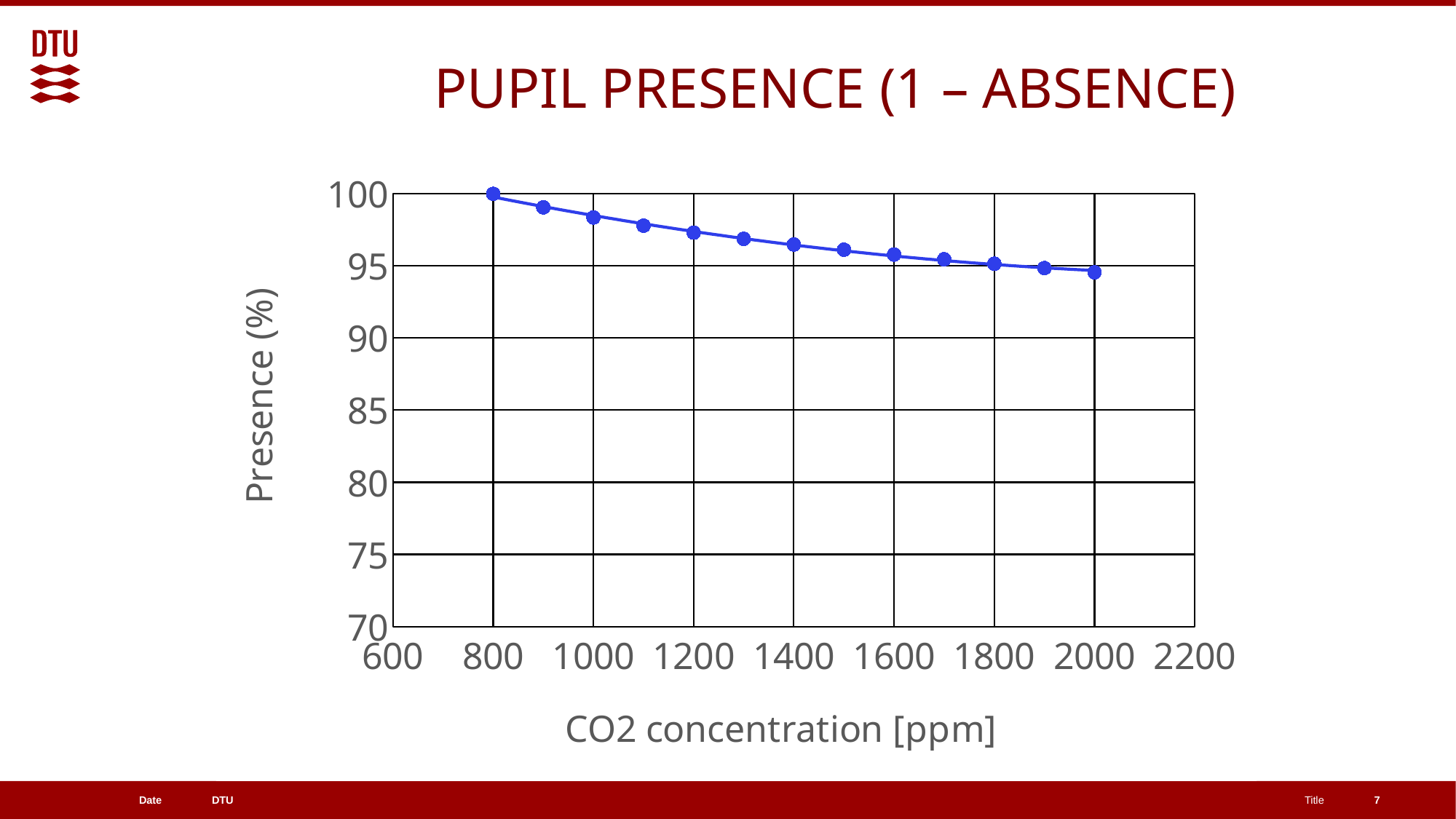
At which CO2 concentration is presence lowest? 2000 ppm Is the presence value at 2000 ppm greater or less than 90? greater Is the presence value at 1000 ppm greater or less than 95? greater What kind of chart is shown on the slide? Line chart What is the title of the chart's x axis? CO2 concentration [ppm] What is the title of the chart's y axis? Presence (%) How many data points are plotted on the chart? 13 Which has a higher presence value: 1000 ppm or 1800 ppm? 1000 ppm At which CO2 concentration is presence highest? 800 ppm Is the presence value at 1400 ppm greater or less than 95? greater Do the presence values rise or fall as CO2 concentration increases? Fall What is the presence value at a CO2 concentration of 800 ppm? 100